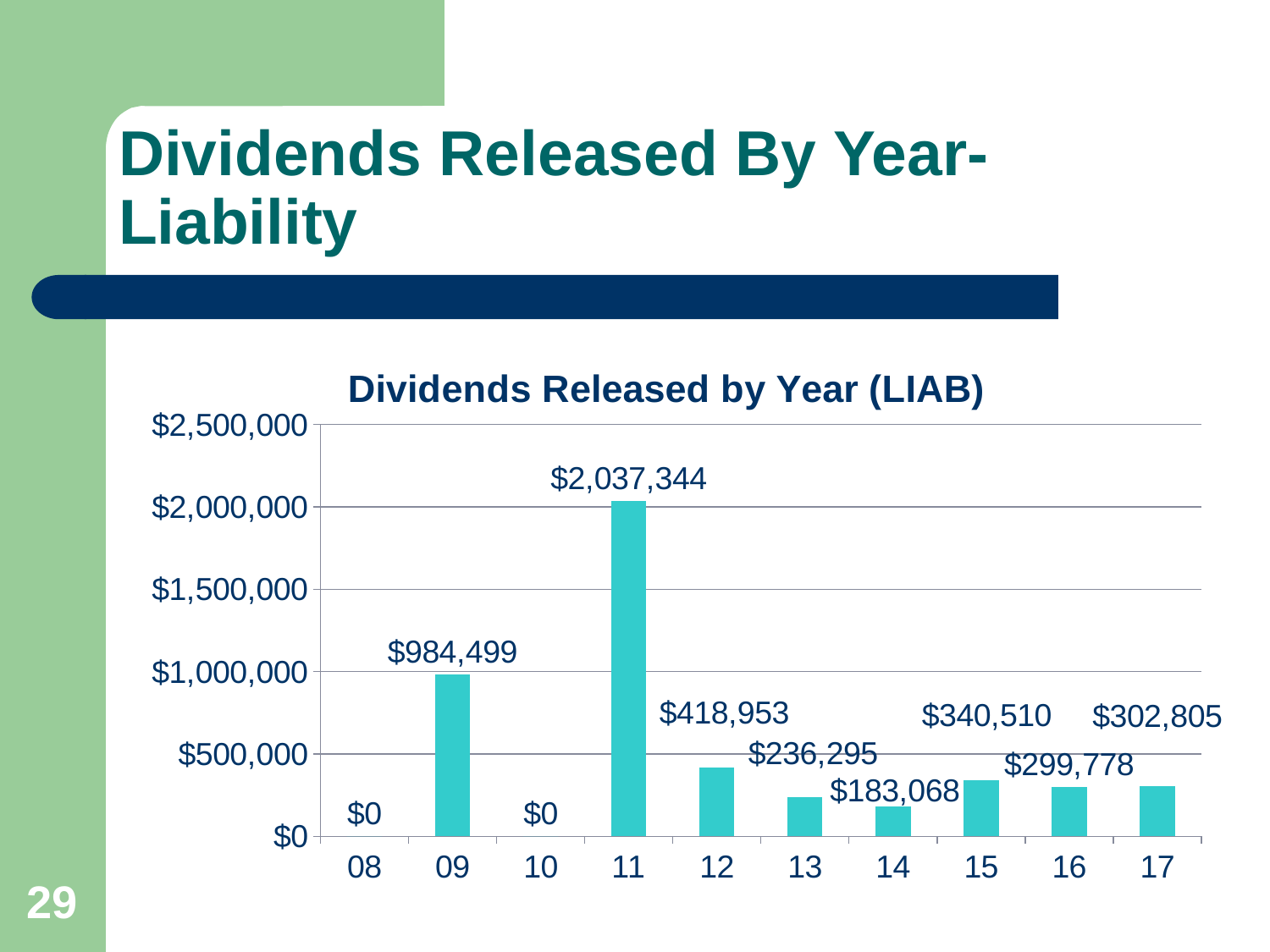
What is the value for 17? $302,805 Which is larger, the value for 12 or the value for 13? 12 What kind of chart is this? Bar chart Which years have a value of $0? 08 and 10 How many years are shown on the x axis? 10 What is the difference between the values for 11 and 09? $1,052,845 Which year has the highest value? 11 What is the value for 14? $183,068 What is the title of the chart? Dividends Released by Year (LIAB) What is the value for 09? $984,499 What is the value for 11? $2,037,344 What is the difference between the values for 15 and 16? $40,732